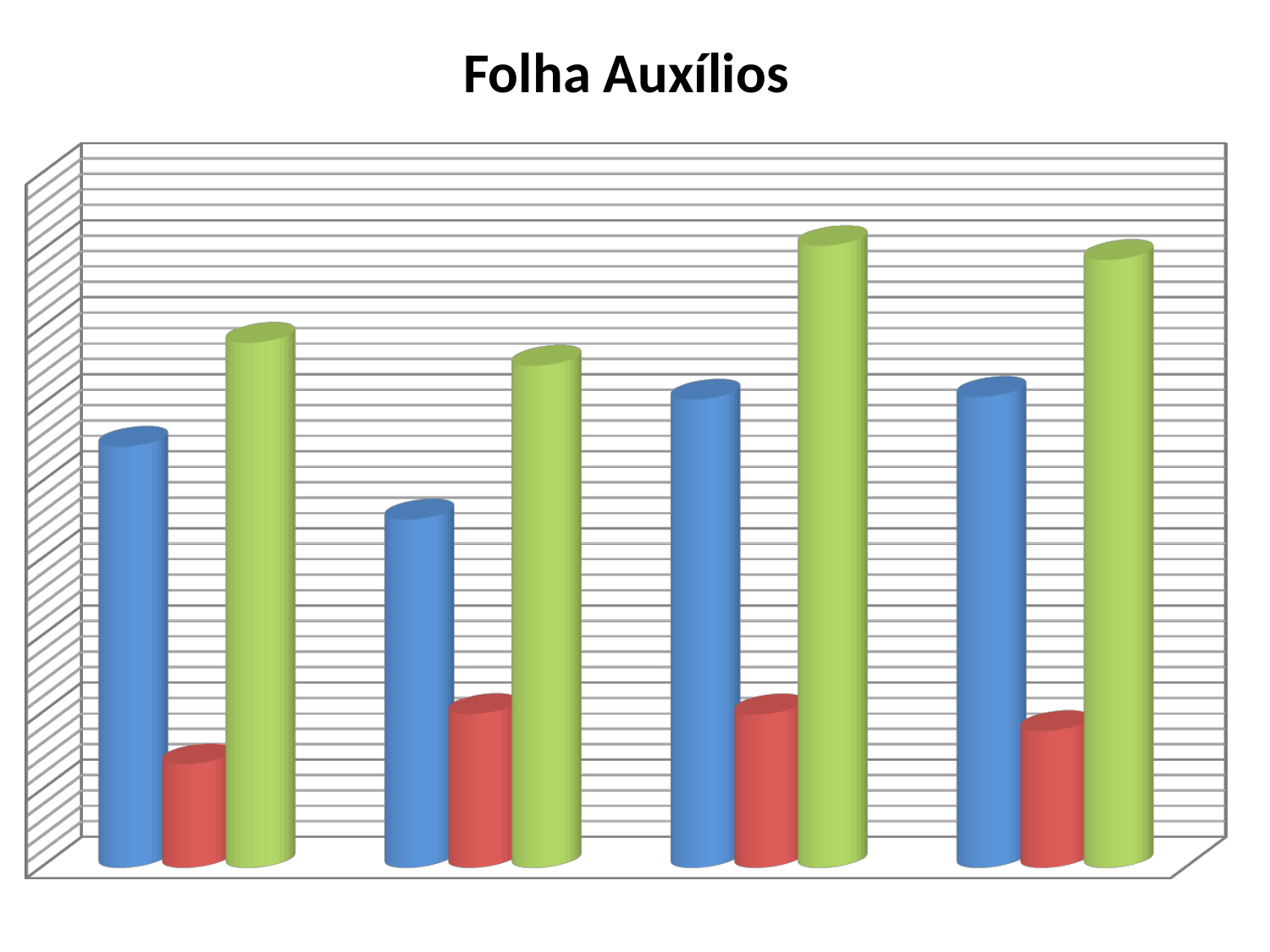
How many bars are there in each group of the chart? 3 How many groups of bars are plotted in the chart? 4 What is the title of the chart? Folha Auxílios Does the chart display a legend? No What colours are the bars in the chart? blue, red and green Which colour of bar is the tallest in every group of the chart? green Which colour of bar is the shortest in every group of the chart? red What kind of chart is shown on the slide? bar chart